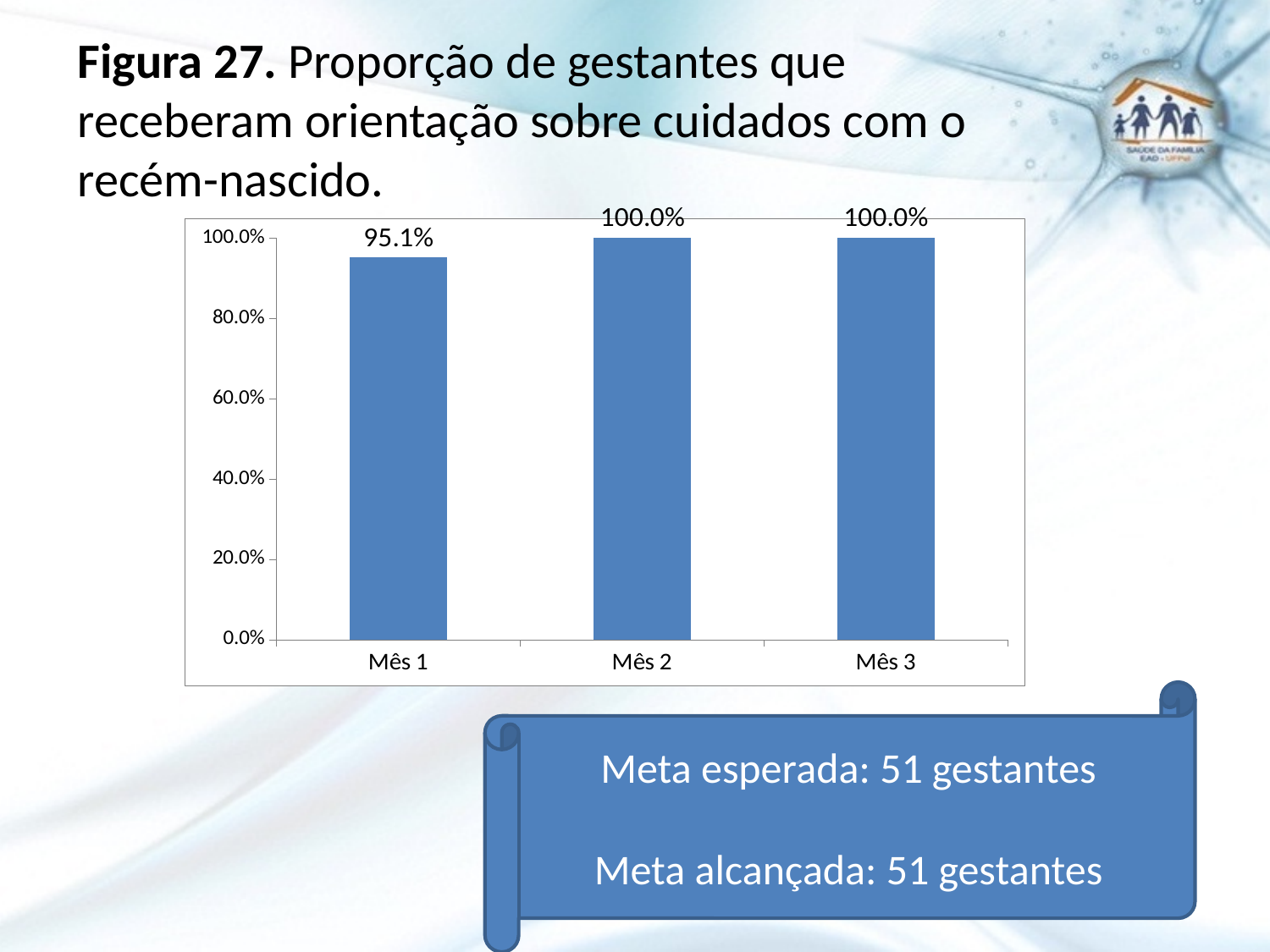
What is the value for Mês 3? 100.0% What is the value for Mês 2? 100.0% What is the difference between the values for Mês 2 and Mês 1? 4.9% Is the value for Mês 1 greater or less than 80.0%? greater What is the value for Mês 1? 95.1% Which is larger, the value for Mês 1 or the value for Mês 3? Mês 3 Do the values rise or fall from Mês 1 to Mês 2? rise How many months are shown on the x axis? 3 Which month has the lowest value? Mês 1 What kind of chart is shown on the slide? bar chart What is the figure number given in the slide title? Figura 27 What is the highest value shown on the y axis? 100.0%